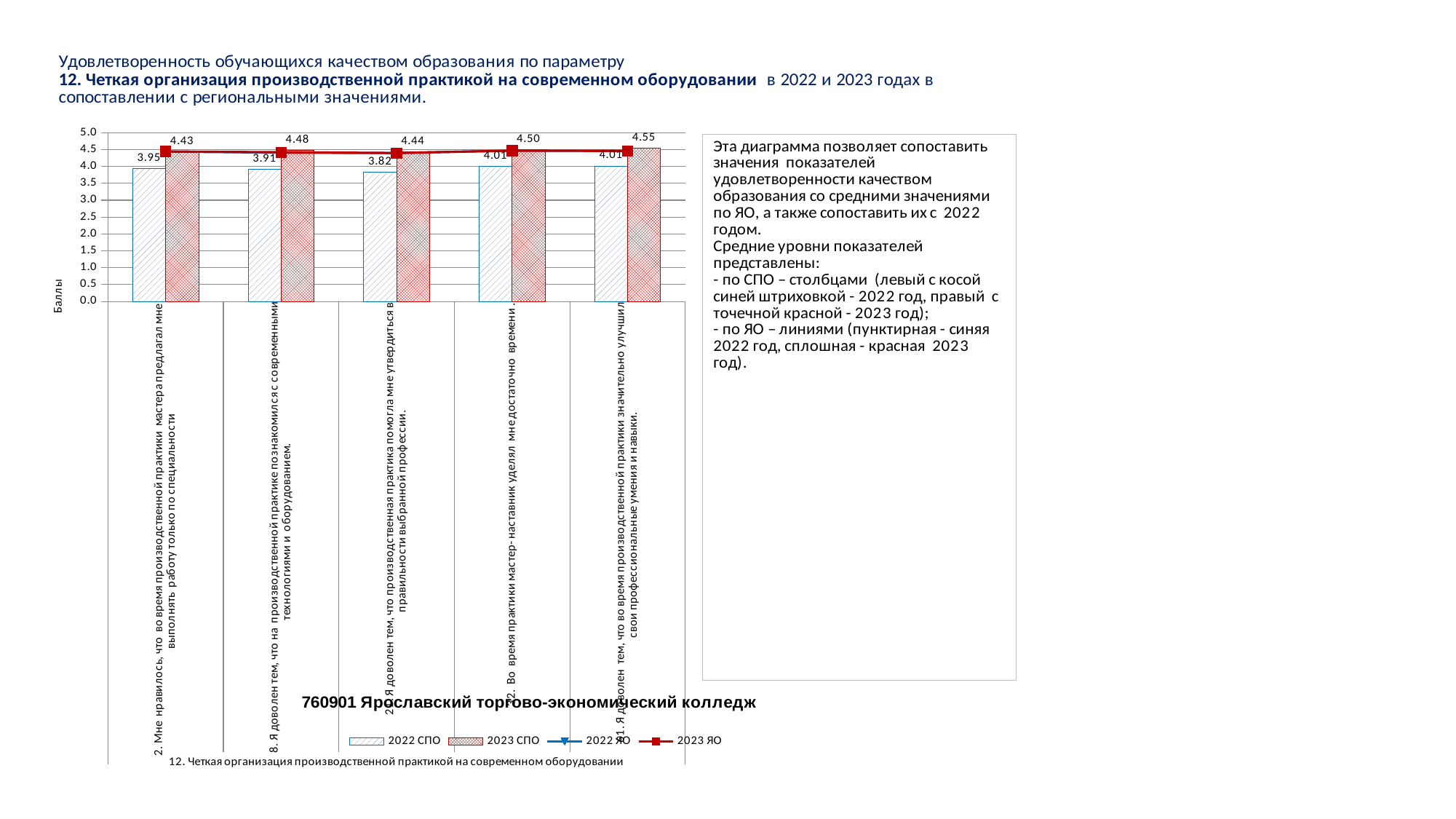
What kind of chart is shown on the slide? Bar chart with line series For the category "производственная практика помогла мне утвердиться в правильности выбранной профессии", which is larger: the 2022 СПО value or the 2023 СПО value? 2023 СПО What is the difference between the 2023 СПО and 2022 СПО values for the last category ("значительно улучшил свои профессиональные умения и навыки")? 0.54 How many categories are shown on the x axis of the chart? 5 How many series does the chart legend list? 4 What is the 2022 СПО value for the category "Во время практики мастер-наставник уделял мне достаточно времени"? 4.01 Which category has the highest 2023 СПО value? 61. Я доволен тем, что во время производственной практики значительно улучшил свои профессиональные умения и навыки. What is the 2023 СПО value for the category "Я доволен тем, что на производственной практике познакомился с современными технологиями и оборудованием"? 4.48 What is the label of the vertical axis of the chart? Баллы What is the 2022 СПО value for the first category ("Мне нравилось, что во время производственной практики мастера предлагал мне выполнять работу только по специальности")? 3.95 Is the 2022 СПО value for the first category greater or less than 3.5? greater Which category has the lowest 2022 СПО value? 21. Я доволен тем, что производственная практика помогла мне утвердиться в правильности выбранной профессии.